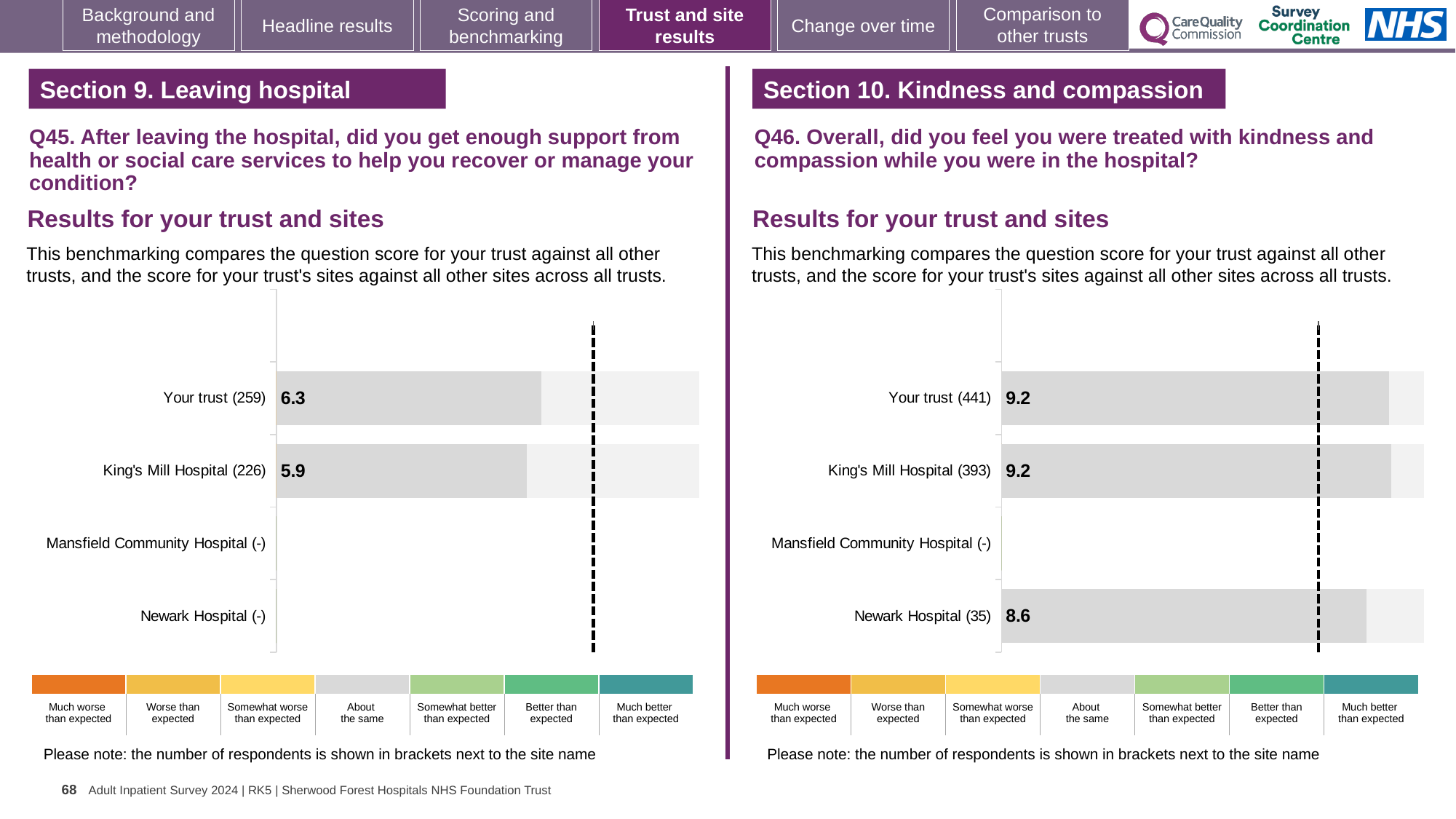
In the Q46 chart on the right, which site has the lowest score among those with a value shown? Newark Hospital In the Q45 chart on the left, what is the difference between the Your trust score and the King's Mill Hospital score? 0.4 How many site rows (including Your trust) are listed in the Q45 chart on the left? 4 In the Q45 chart on the left, what is the score for King's Mill Hospital? 5.9 In the Q45 chart on the left, what is the score for Your trust? 6.3 In the Q45 chart on the left, which is larger, the score for Your trust or the score for King's Mill Hospital? Your trust In the Q46 chart on the right, what is the score for King's Mill Hospital? 9.2 In the Q45 chart on the left, how many respondents are shown in brackets for King's Mill Hospital? 226 In the Q46 chart on the right, what is the score for Newark Hospital? 8.6 In the Q46 chart on the right, what is the difference between the Your trust score and the Newark Hospital score? 0.6 In the Q46 chart on the right, how many respondents are shown in brackets for Your trust? 441 What kind of chart is used for the Q46 results on the right? Bar chart